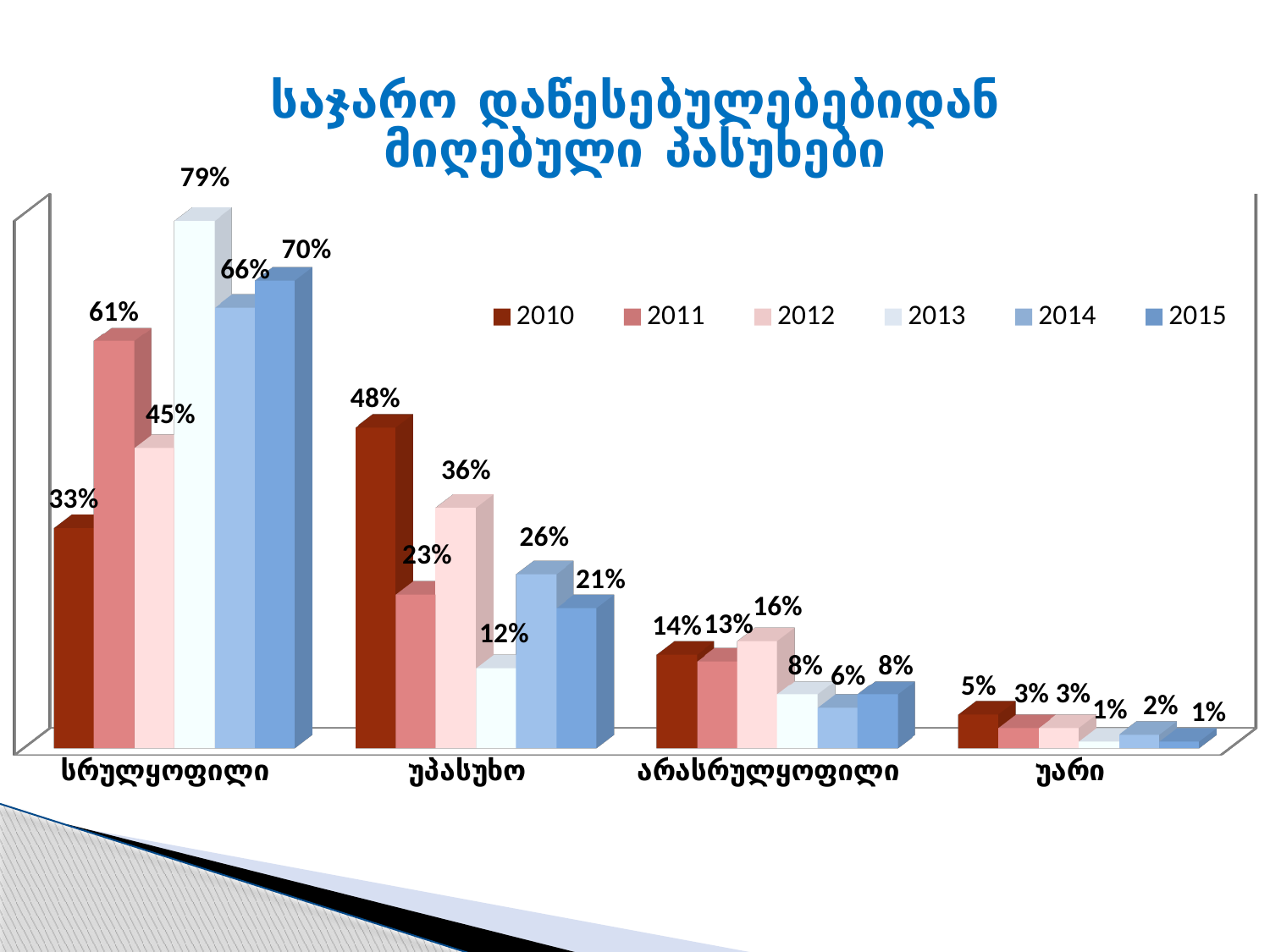
What is the value for 2015 in the უარი category? 1% How many series does the legend list? 6 How many categories are shown on the x axis? 4 What kind of chart is shown on the slide? Bar chart What is the value for 2013 in the სრულყოფილი category? 79% Which is larger in the უპასუხო category: the value for 2012 or the value for 2014? 2012 What is the difference between the 2015 and 2010 values in the სრულყოფილი category? 37% Which year is shown in the darkest red colour in the legend? 2010 Which year has the highest value in the სრულყოფილი category? 2013 What is the value for 2014 in the არასრულყოფილი category? 6% What is the value for 2010 in the უპასუხო category? 48% Which year has the lowest value in the უპასუხო category? 2013